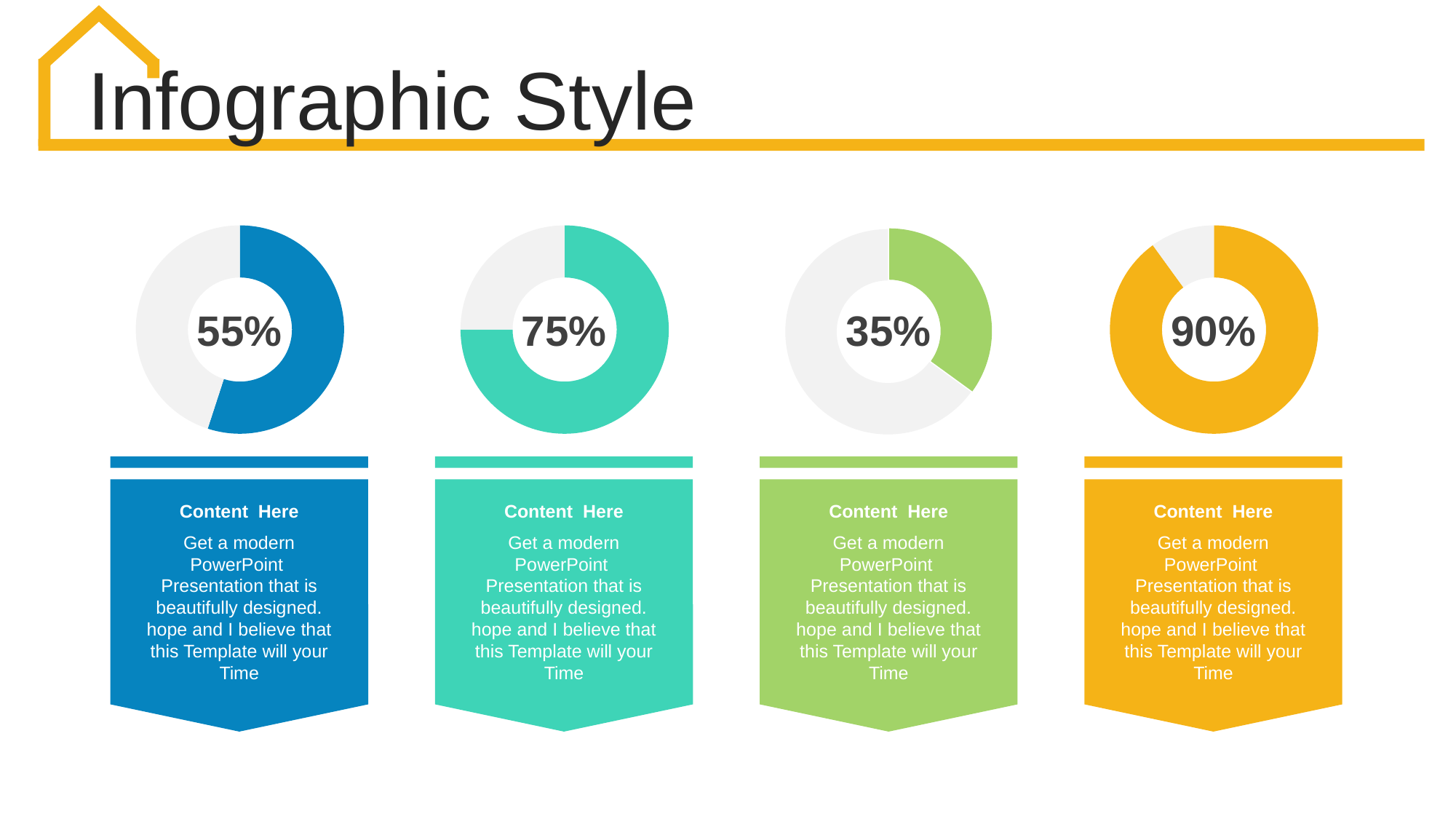
What value is shown in the centre of the second (teal) donut chart from the left? 75% What value is shown in the centre of the rightmost (yellow) donut chart? 90% Which donut chart shows the lowest percentage? The third (green) chart, 35% What value is shown in the centre of the leftmost (blue) donut chart? 55% What value is shown in the centre of the third (green) donut chart from the left? 35% Which is larger, the percentage in the blue donut chart or the percentage in the teal donut chart? The teal donut chart (75%) What is the title of the slide? Infographic Style What is the difference between the percentage in the yellow donut chart and the percentage in the green donut chart? 55% How many donut charts are on the slide? 4 What kind of chart is used to display the percentages on the slide? Donut chart Which donut chart shows the highest percentage? The rightmost (yellow) chart, 90% What is the difference between the percentage in the teal donut chart and the percentage in the blue donut chart? 20%